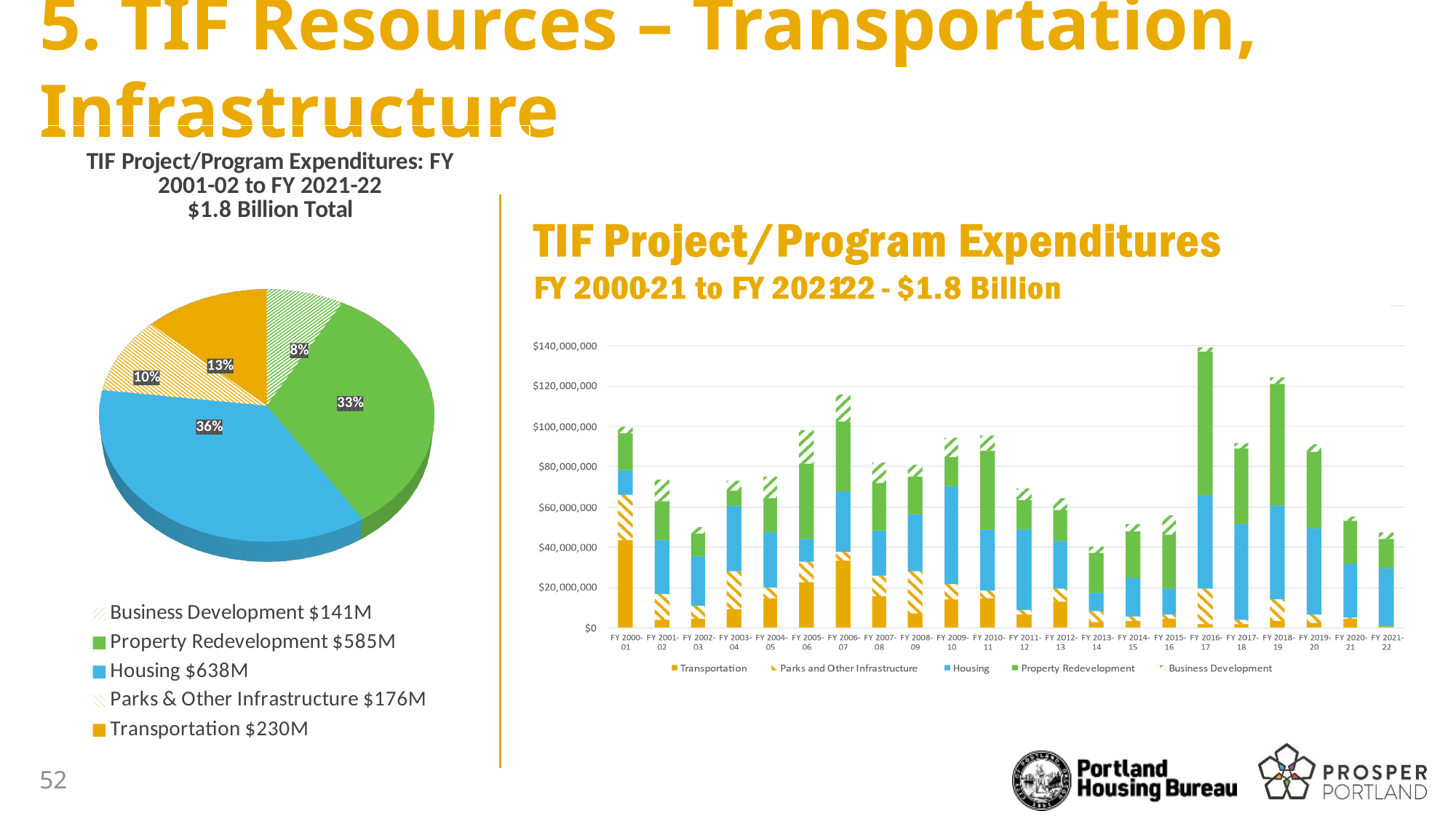
On the pie chart on the left, which category has the largest share? Housing On the pie chart on the left, what dollar amount does the legend give for Property Redevelopment? $585M On the pie chart on the left, how many categories are shown? 5 On the pie chart on the left, which category has the smallest share? Business Development On the bar chart on the right, is the total for FY 2016-17 greater or less than $120,000,000? greater On the pie chart on the left, what share of expenditures is Business Development? 8% On the bar chart on the right, how many series does the legend list? 5 On the bar chart on the right, which fiscal year has the lowest total expenditure? FY 2013-14 On the pie chart on the left, what share of expenditures is Housing? 36% On the bar chart on the right, which fiscal year has the highest total expenditure? FY 2016-17 On the pie chart on the left, how much larger is the Housing amount than the Parks & Other Infrastructure amount? $462M On the pie chart on the left, what dollar amount does the legend give for Transportation? $230M